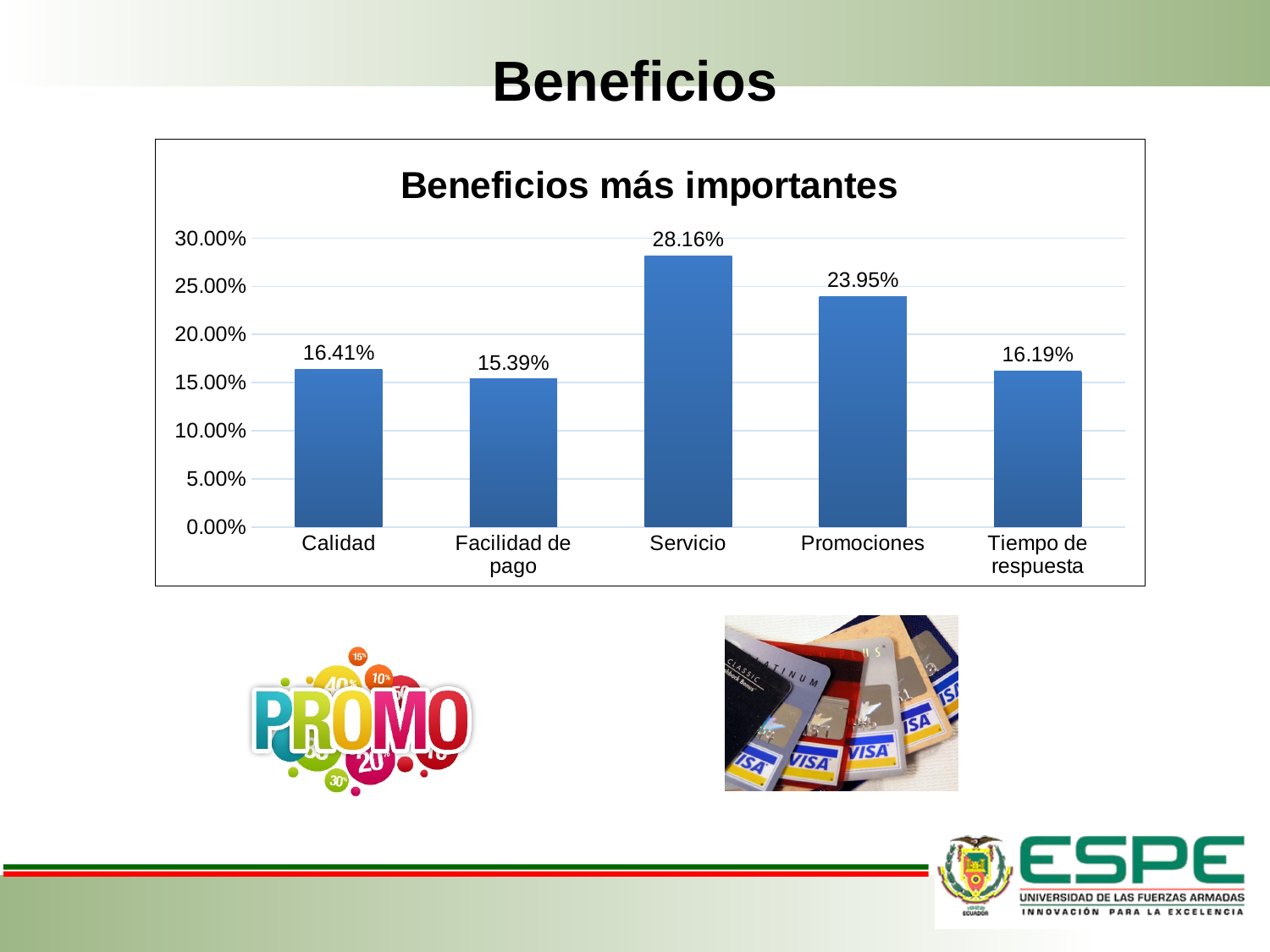
Which is larger, the value for Calidad or the value for Tiempo de respuesta? Calidad What is the difference between the values for Calidad and Facilidad de pago? 1.02% Which category has the lowest value? Facilidad de pago What is the difference between the values for Servicio and Promociones? 4.21% What is the title of the chart? Beneficios más importantes What is the value for Servicio? 28.16% Is the value for Promociones greater or less than 20.00%? greater What is the value for Facilidad de pago? 15.39% What is the value for Tiempo de respuesta? 16.19% How many categories are shown on the x axis? 5 Which category has the highest value? Servicio What kind of chart is shown? Bar chart